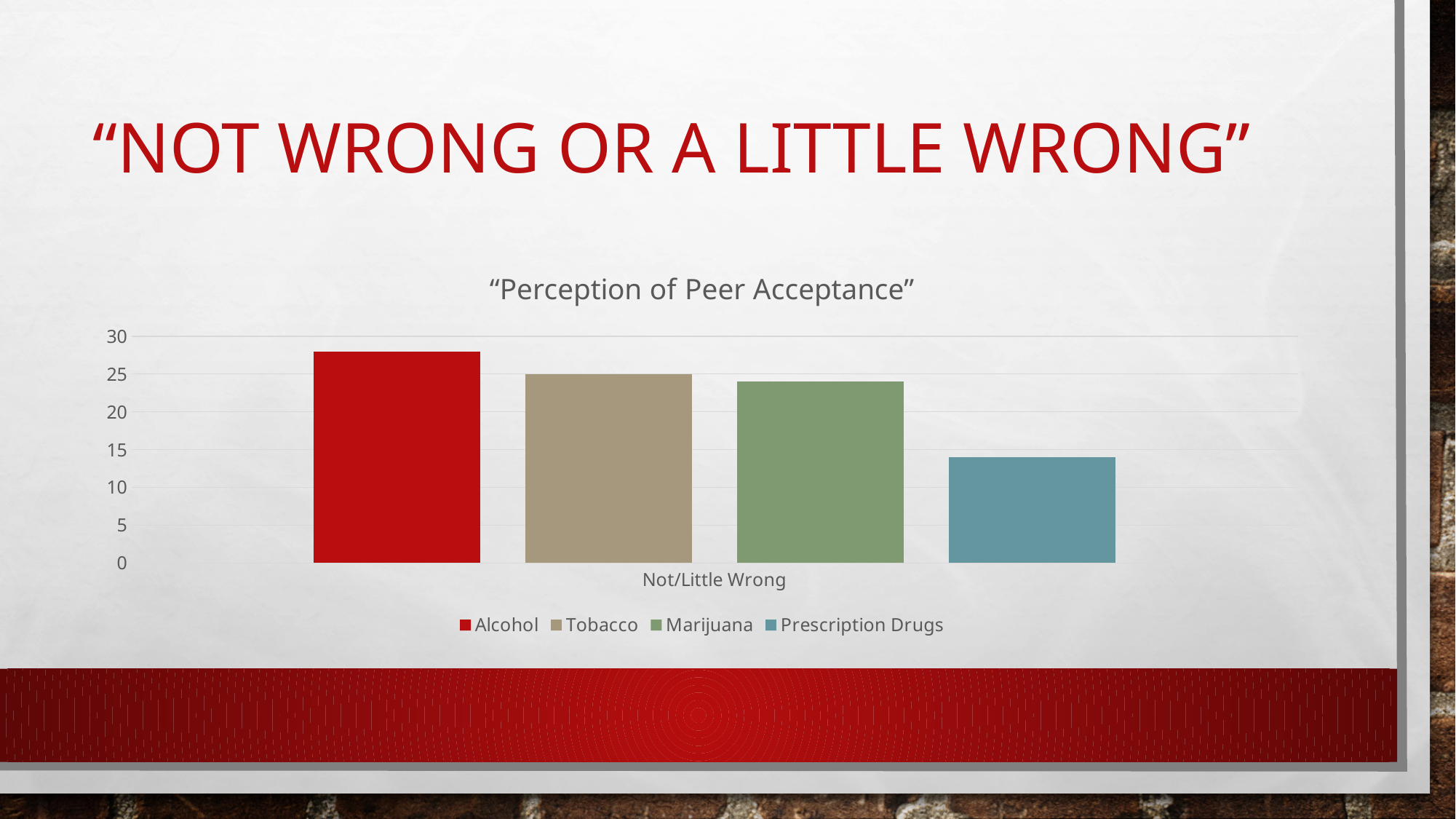
Is the value for Alcohol greater or less than 25? greater How many series does the legend list? 4 Which series has the lowest value? Prescription Drugs What kind of chart is shown on the slide? bar chart Which series has the highest value? Alcohol How many categories are shown on the x axis? 1 Which is larger, the value for Tobacco or the value for Marijuana? Tobacco Is the value for Marijuana greater or less than 20? greater What is the category label on the x axis? Not/Little Wrong Is the value for Prescription Drugs greater or less than 15? less What is the title of the chart? "Perception of Peer Acceptance" Which is larger, the value for Alcohol or the value for Prescription Drugs? Alcohol